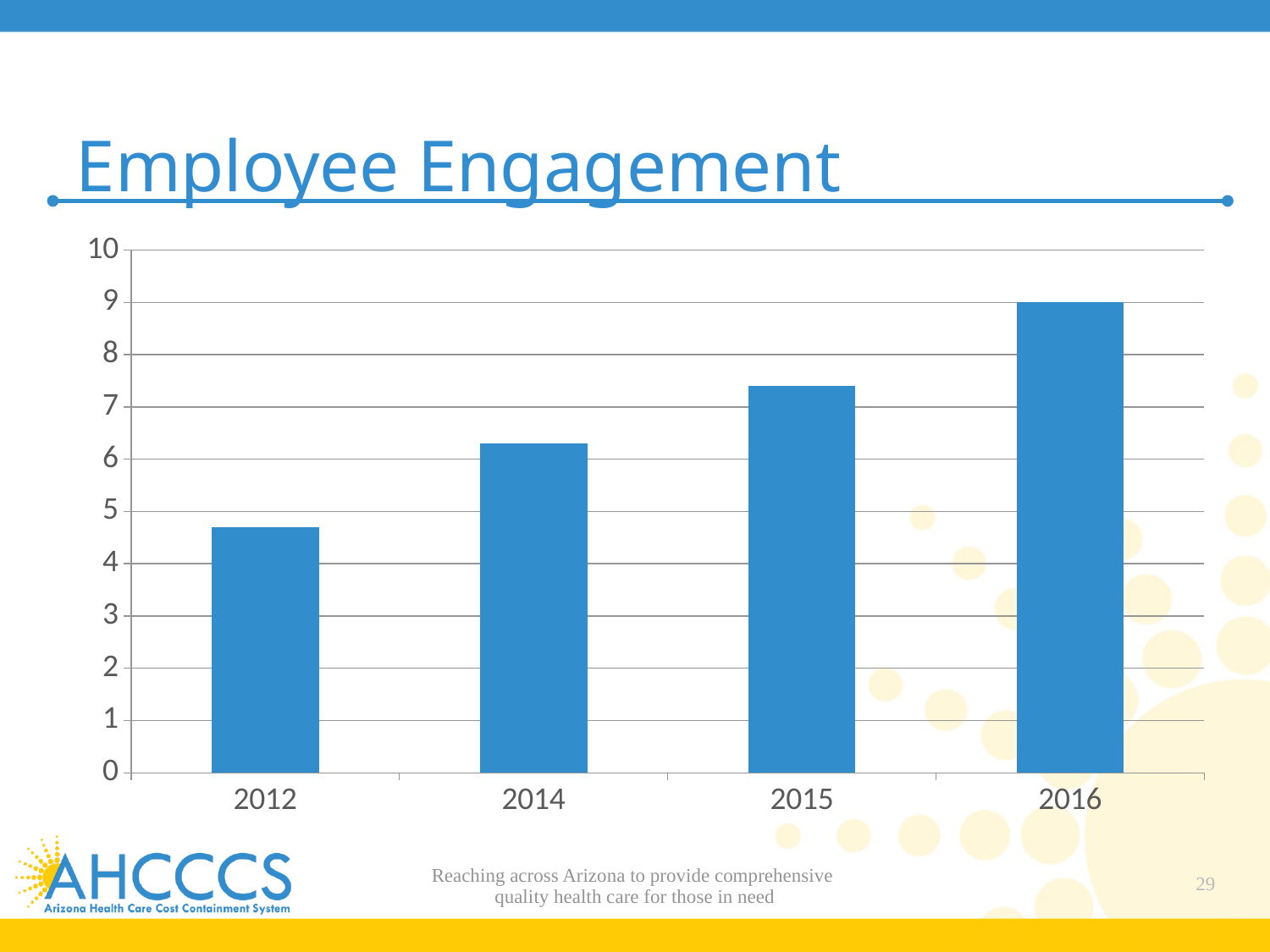
Which year has the lowest bar? 2012 Do the values rise or fall from 2012 to 2016? rise Is the value for 2012 greater or less than 5? less How many years are shown on the x axis of the chart? 4 What is the title of the chart? Employee Engagement Is the value for 2015 greater or less than 8? less Is the value for 2014 greater or less than 6? greater Which is larger, the value for 2014 or the value for 2015? 2015 What kind of chart is shown on the slide? bar chart Which year has the highest bar? 2016